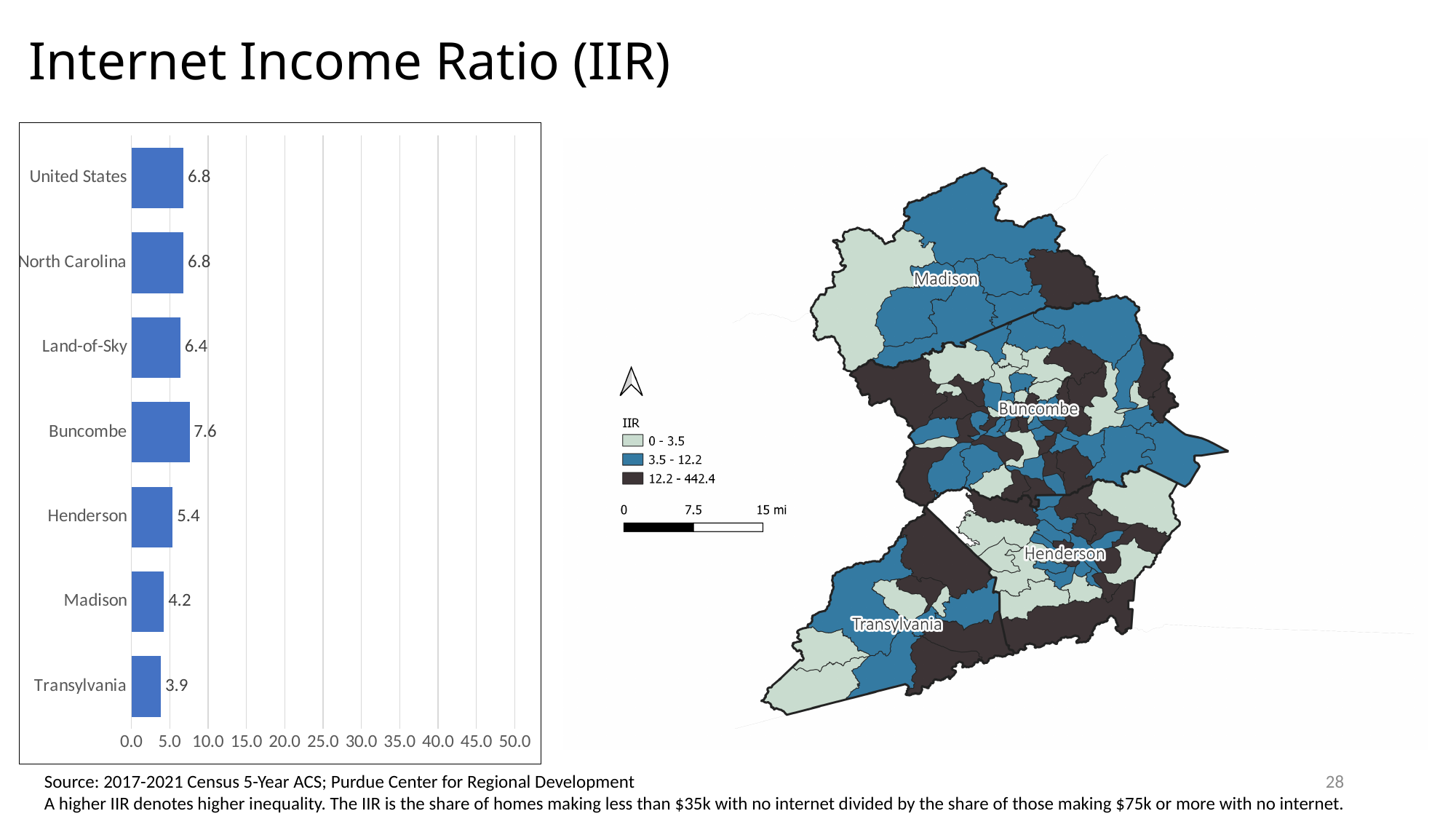
Which has a larger IIR value, Henderson or Madison? Henderson What kind of chart is shown on the left of the slide? bar chart What is the difference between the IIR values for Buncombe and Madison? 3.4 What is the IIR value for Land-of-Sky in the bar chart? 6.4 How many categories are shown in the bar chart? 7 How many IIR ranges does the map legend list? 3 Which category has the highest IIR value in the bar chart? Buncombe Is the IIR value for Buncombe greater or less than 5.0? greater What is the highest value shown on the x axis of the bar chart? 50.0 What is the IIR value for Buncombe in the bar chart? 7.6 What is the IIR value for Transylvania in the bar chart? 3.9 Which category has the lowest IIR value in the bar chart? Transylvania